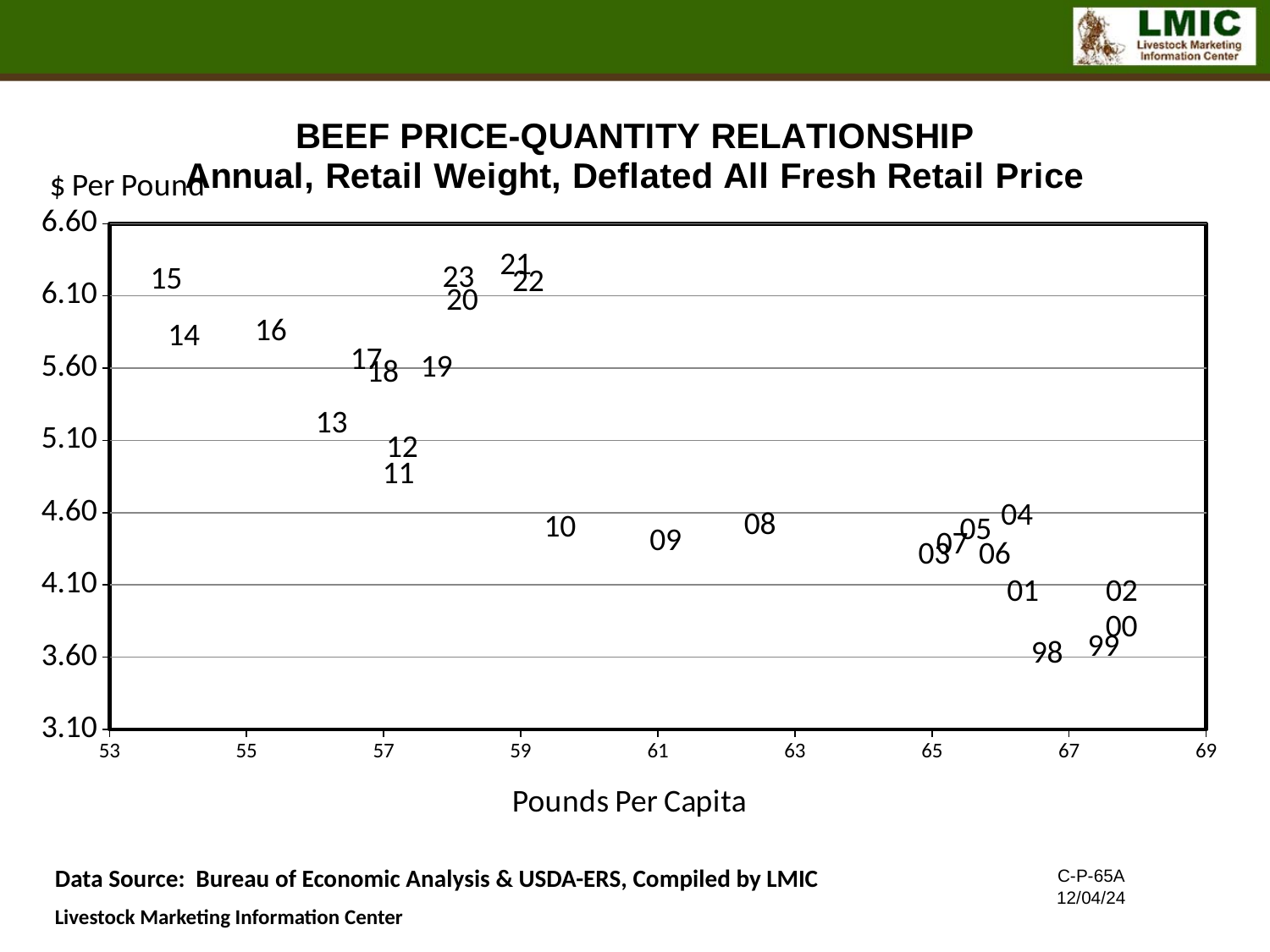
How many year points are plotted on the chart? 26 What unit is shown on the y axis label? $ Per Pound What is the title of the x axis? Pounds Per Capita What kind of chart is shown on the slide? Scatter chart As pounds per capita increases along the x axis, does the price per pound generally rise or fall? fall Is the price per pound for year 13 greater or less than 5.10? greater Is the price per pound for year 10 greater or less than 4.60? less Which year has the higher price per pound, 15 or 10? 15 Is the pounds per capita value for year 02 greater or less than 67? greater